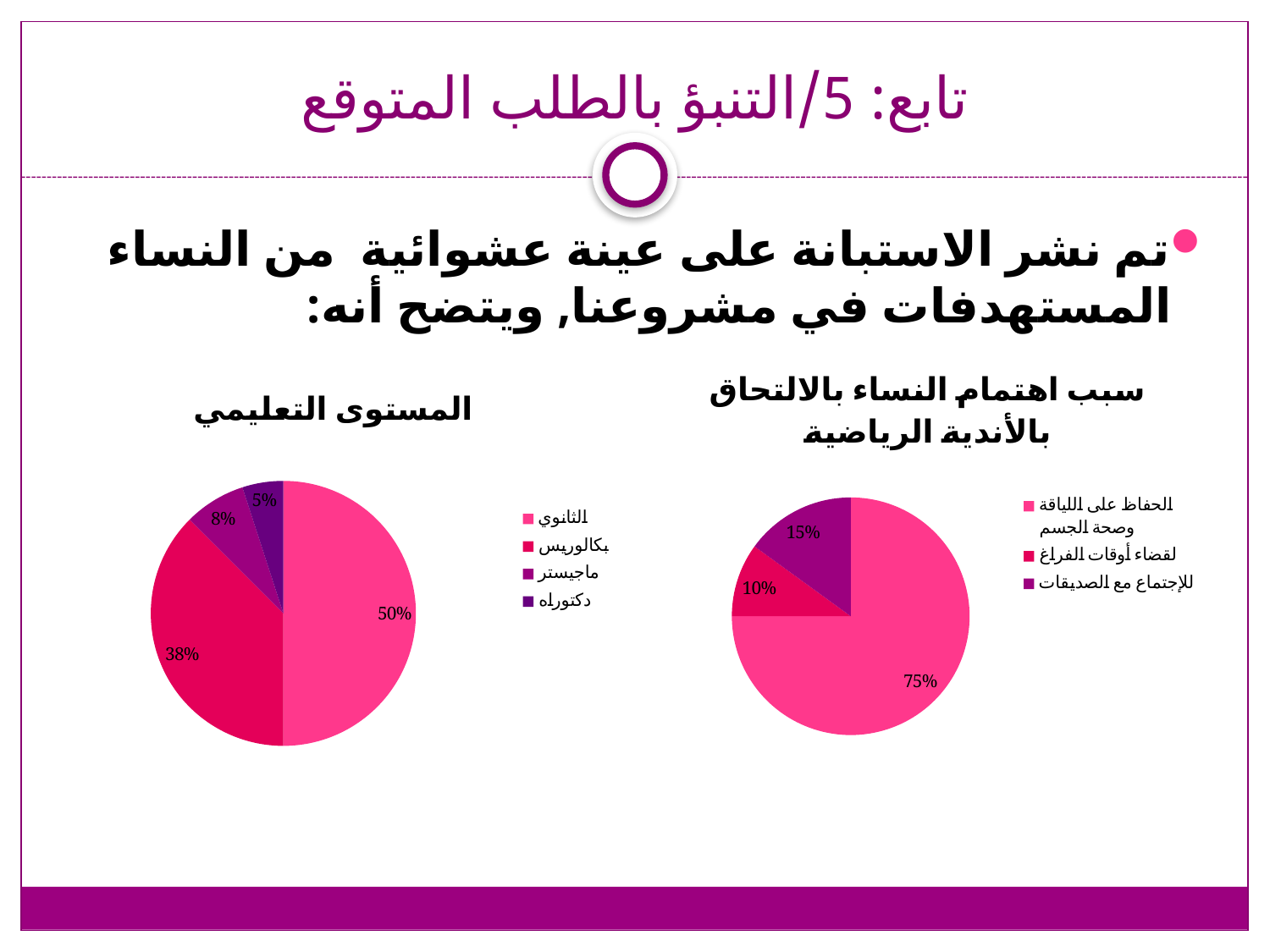
In the left chart titled "المستوى التعليمي", which category has the smallest slice? دكتوراه What type of chart is the left chart titled "المستوى التعليمي"? Pie chart How many categories does the legend of the right chart titled "سبب اهتمام النساء بالالتحاق بالأندية الرياضية" list? 3 In the left chart titled "المستوى التعليمي", what share does "دكتوراه" have? 5% In the left chart titled "المستوى التعليمي", what share does "بكالوريس" have? 38% In the right chart titled "سبب اهتمام النساء بالالتحاق بالأندية الرياضية", which is larger: "لقضاء أوقات الفراغ" or "للإجتماع مع الصديقات"? للإجتماع مع الصديقات In the left chart titled "المستوى التعليمي", what share does "الثانوي" have? 50% In the left chart titled "المستوى التعليمي", what is the difference between the shares of "الثانوي" and "بكالوريس"? 12% How many slices does the left chart titled "المستوى التعليمي" have? 4 In the right chart titled "سبب اهتمام النساء بالالتحاق بالأندية الرياضية", which category has the largest slice? الحفاظ على اللياقة وصحة الجسم